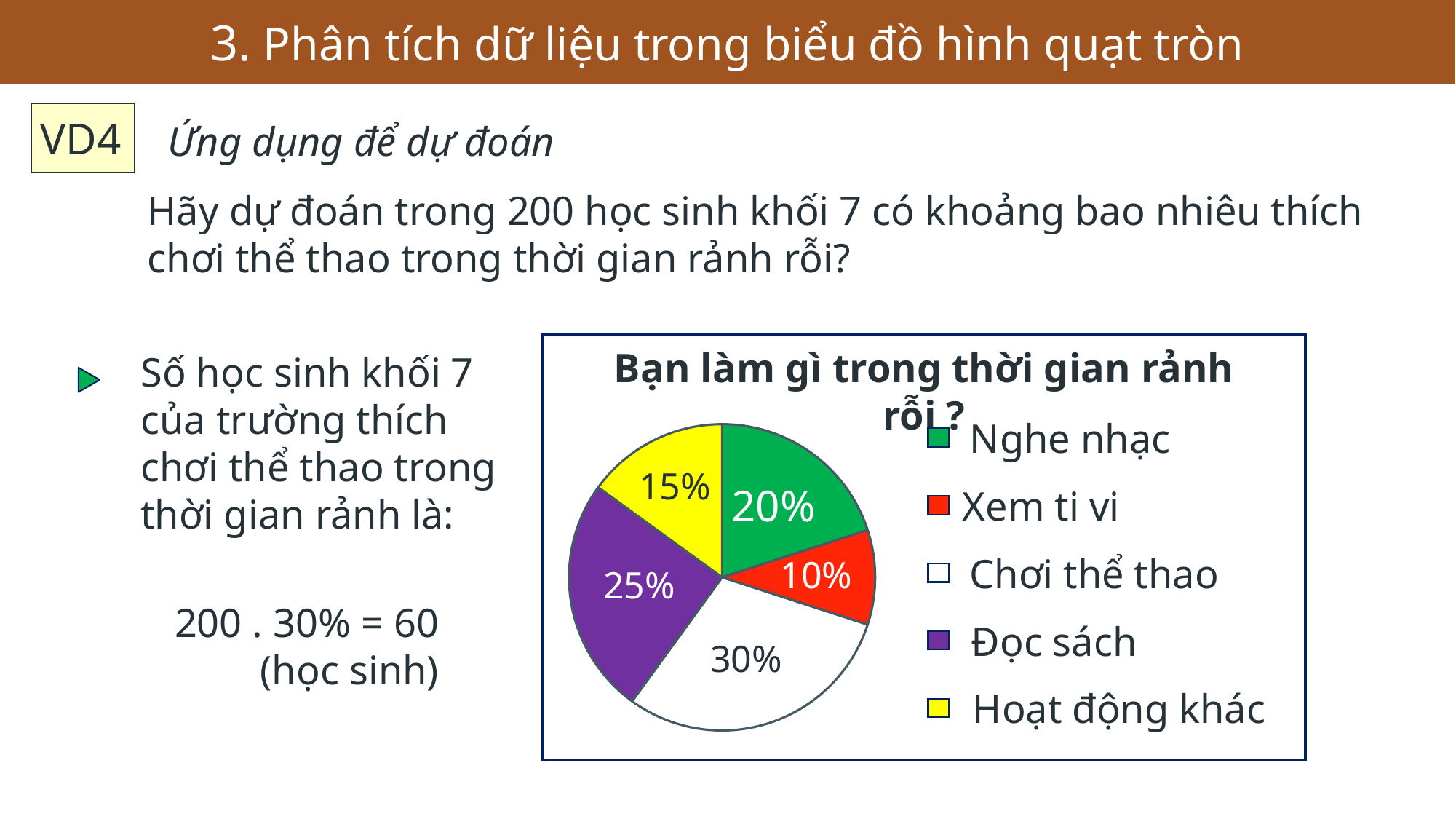
Which activity has the largest share of the pie? Chơi thể thao What percentage of the pie is Chơi thể thao? 30% How many categories does the pie chart have? 5 What percentage of the pie is Hoạt động khác? 15% What kind of chart is shown on the slide? pie chart What percentage of the pie is Xem ti vi? 10% Which activity has the smallest share of the pie? Xem ti vi What is the title of the pie chart? Bạn làm gì trong thời gian rảnh rỗi? Which is larger, the share for Nghe nhạc or the share for Đọc sách? Đọc sách What percentage of the pie is Đọc sách? 25% What percentage of the pie is Nghe nhạc? 20% What is the difference in percentage points between Đọc sách and Hoạt động khác? 10%